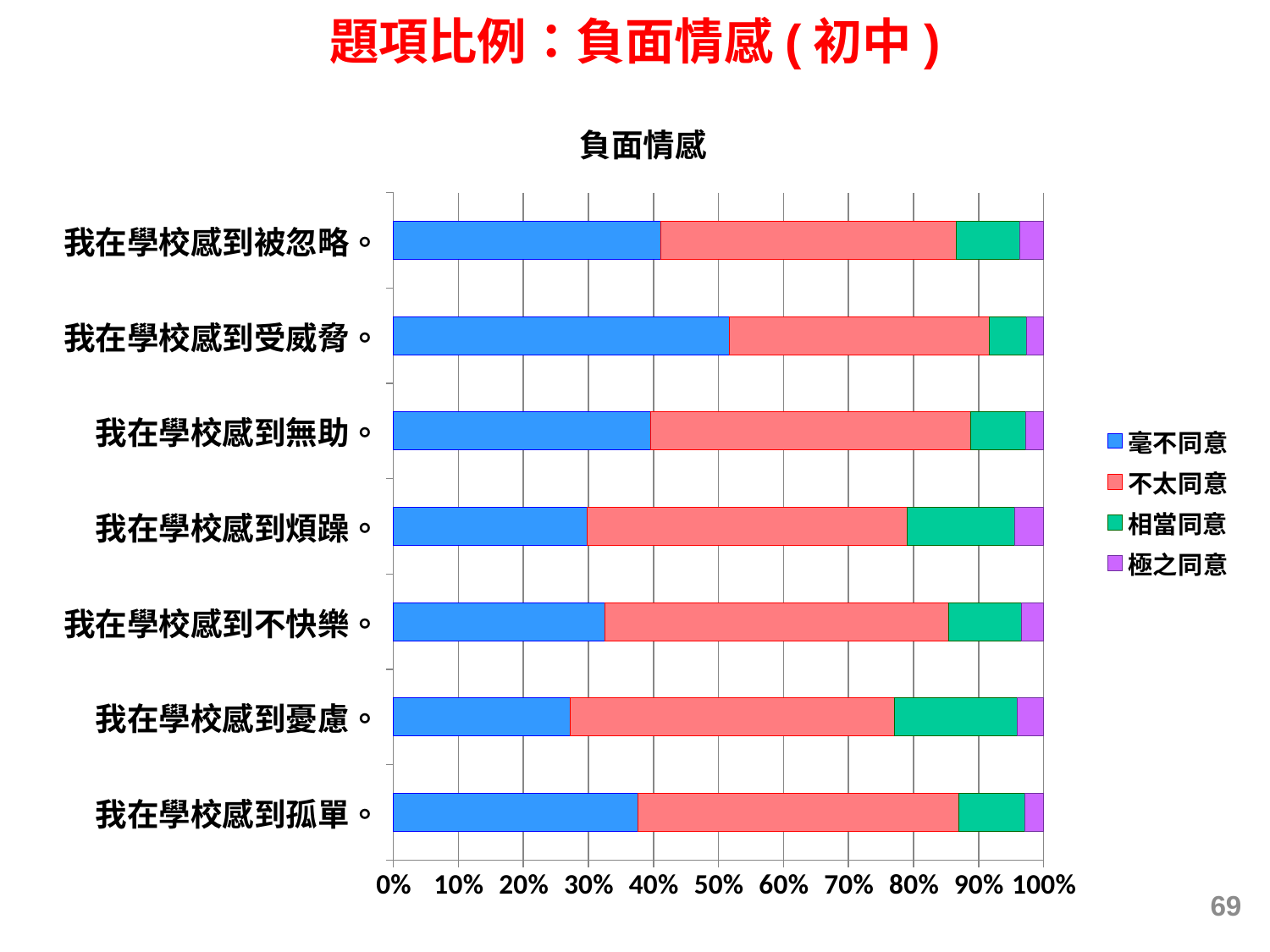
Is the 毫不同意 value for 我在學校感到孤單。 greater or less than 40%? less Which legend entry is shown in green? 相當同意 Which has a larger 毫不同意 segment: 我在學校感到受威脅。 or 我在學校感到憂慮。? 我在學校感到受威脅。 Is the 毫不同意 value for 我在學校感到憂慮。 greater or less than 30%? less What kind of chart is shown on the slide? stacked bar chart What is the title shown above the chart? 負面情感 How many statements (categories) are plotted in the chart? 7 Which statement has the smallest 毫不同意 segment? 我在學校感到憂慮。 Which statement has the largest 毫不同意 segment? 我在學校感到受威脅。 How many series does the legend list? 4 Which has a larger 毫不同意 segment: 我在學校感到無助。 or 我在學校感到煩躁。? 我在學校感到無助。 Is the 毫不同意 value for 我在學校感到受威脅。 greater or less than 50%? greater